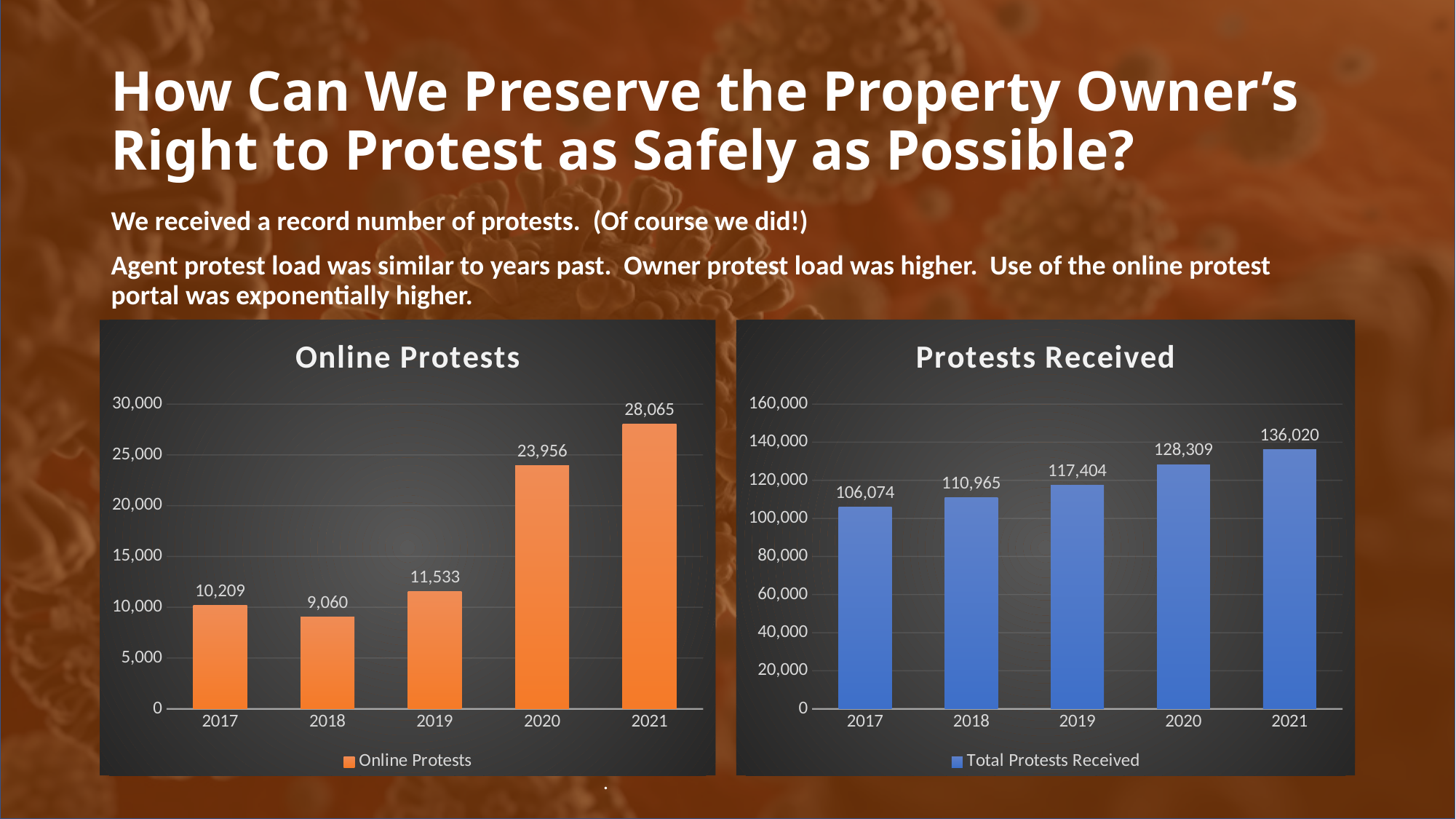
In the Online Protests chart, what is the difference between the 2021 and 2020 values? 4,109 In the Protests Received chart, which year has the highest value? 2021 In the Protests Received chart, what is the value for 2019? 117,404 In the Protests Received chart, what is the difference between the 2018 and 2017 values? 4,891 How many series does the legend of the Protests Received chart list? 1 In the Online Protests chart, which year has the lowest value? 2018 In the Protests Received chart, do the values rise or fall from 2017 to 2021? Rise In the Online Protests chart, what is the value for 2020? 23,956 How many years are shown on the x axis of the Online Protests chart? 5 In the Protests Received chart, is the value for 2020 greater or less than 120,000? greater In the Online Protests chart, which is larger, the value for 2017 or the value for 2019? 2019 What kind of chart is the Protests Received chart? Bar chart